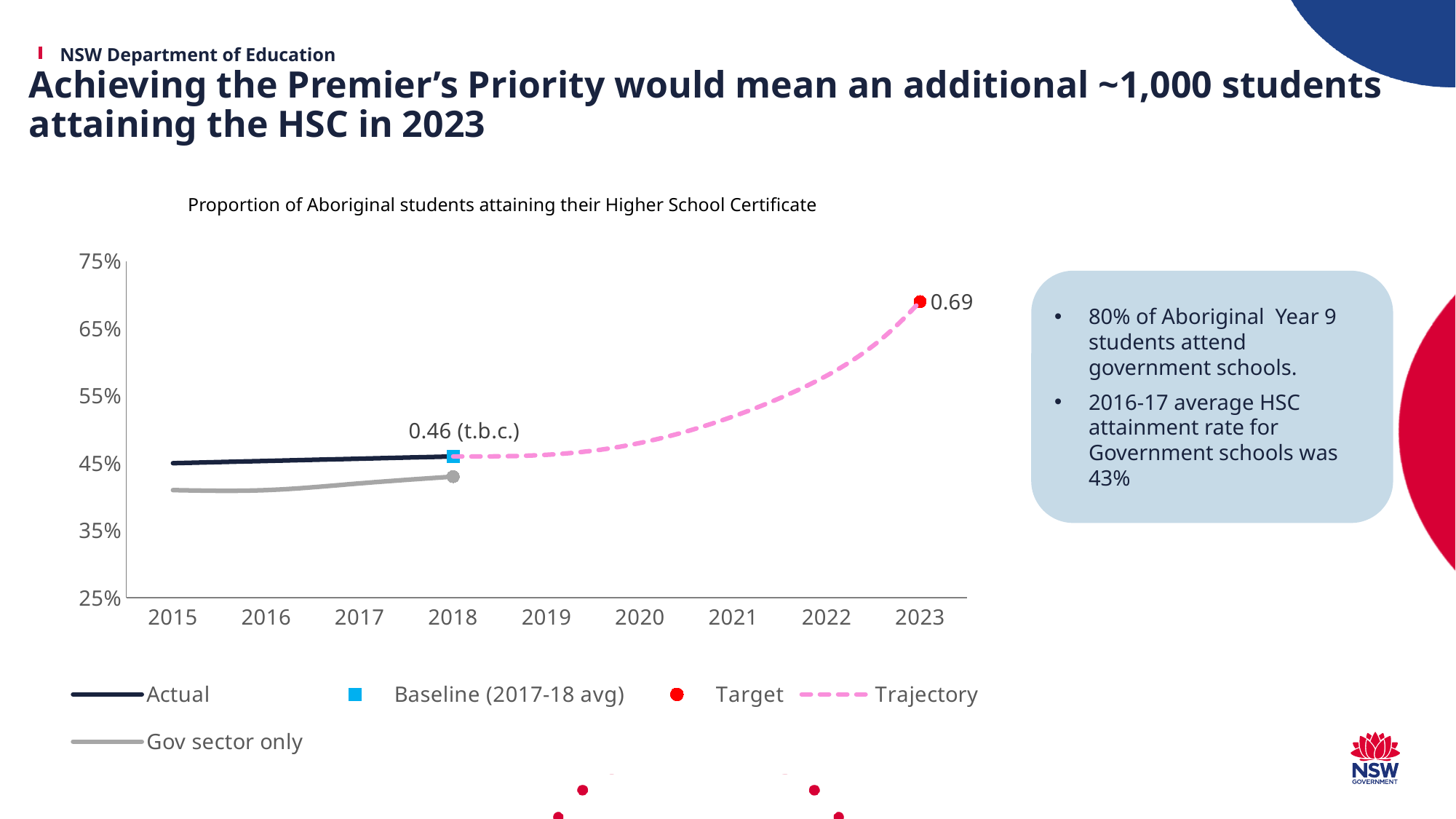
What is the chart's title? Proportion of Aboriginal students attaining their Higher School Certificate Is the Target value in 2023 greater or less than 65%? greater What is the labelled value of the Baseline (2017-18 avg) point? 0.46 (t.b.c.) Does the Gov sector only line rise or fall from 2015 to 2018? rise Which legend entry is drawn as a dashed line? Trajectory In 2018, which is higher: the Actual line or the Gov sector only line? Actual How many years are shown on the x axis? 9 How many series does the legend list? 5 Is the Gov sector only value in 2015 greater or less than 45%? less What is the labelled value of the Target point in 2023? 0.69 What kind of chart is shown on the slide? line chart What is the difference between the Target value (0.69) and the Baseline value (0.46)? 0.23